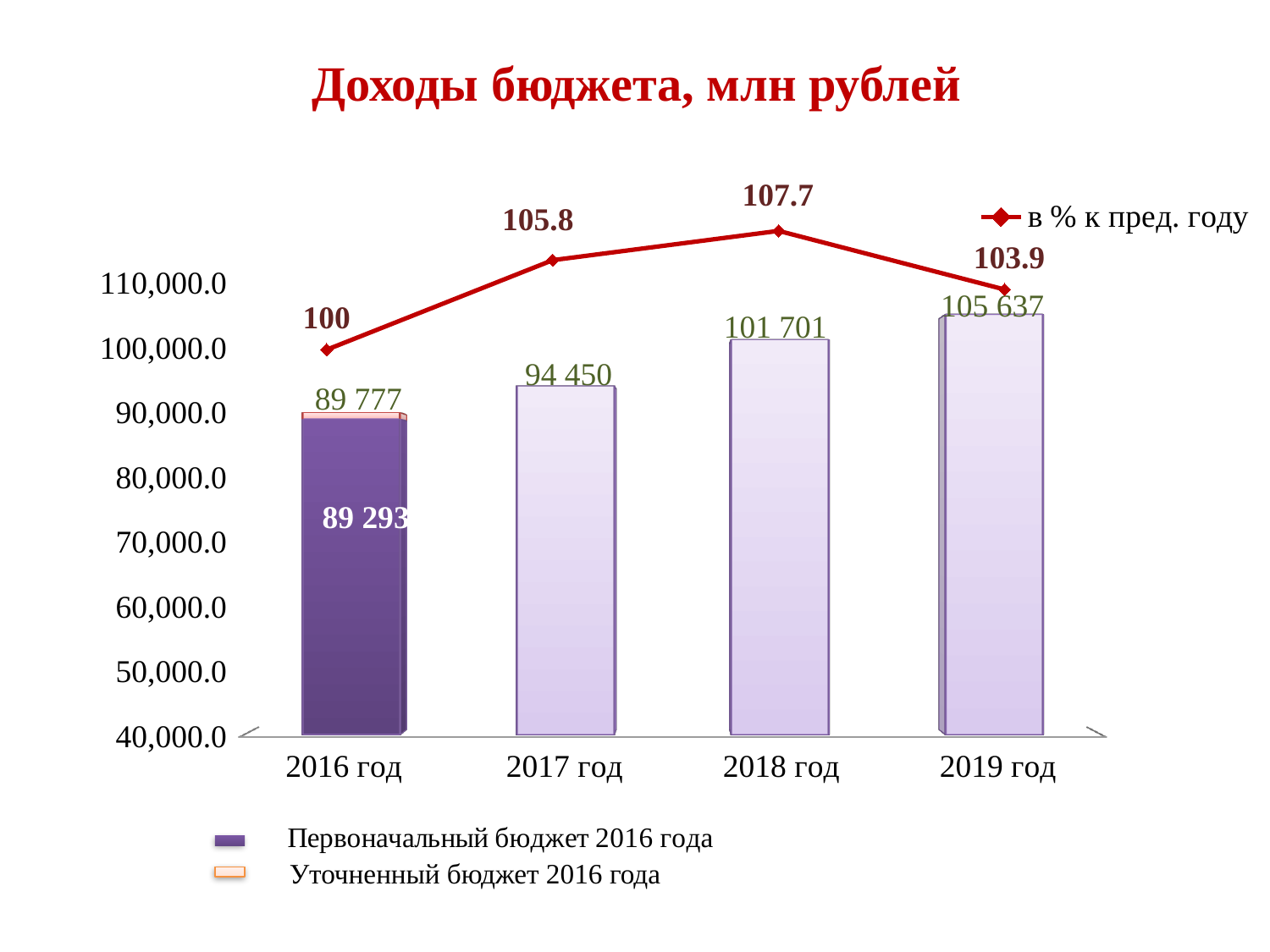
What is the value of the bar for 2017 год? 94 450 Is the bar value for 2017 год greater or less than 90,000.0? greater What is the value of the 'в % к пред. году' line for 2019 год? 103.9 Do the bar values rise or fall from 2017 год to 2019 год? rise What is the value of the 'в % к пред. году' line for 2018 год? 107.7 What is the value labelled on the 'Первоначальный бюджет 2016 года' bar for 2016 год? 89 293 What is the title of the chart? Доходы бюджета, млн рублей What is the value of the bar for 2019 год? 105 637 Which year has the highest bar value? 2019 год Which year has the highest value on the 'в % к пред. году' line? 2018 год What is the difference between the bar values for 2019 год and 2018 год? 3 936 What is the value of the bar for 2018 год? 101 701